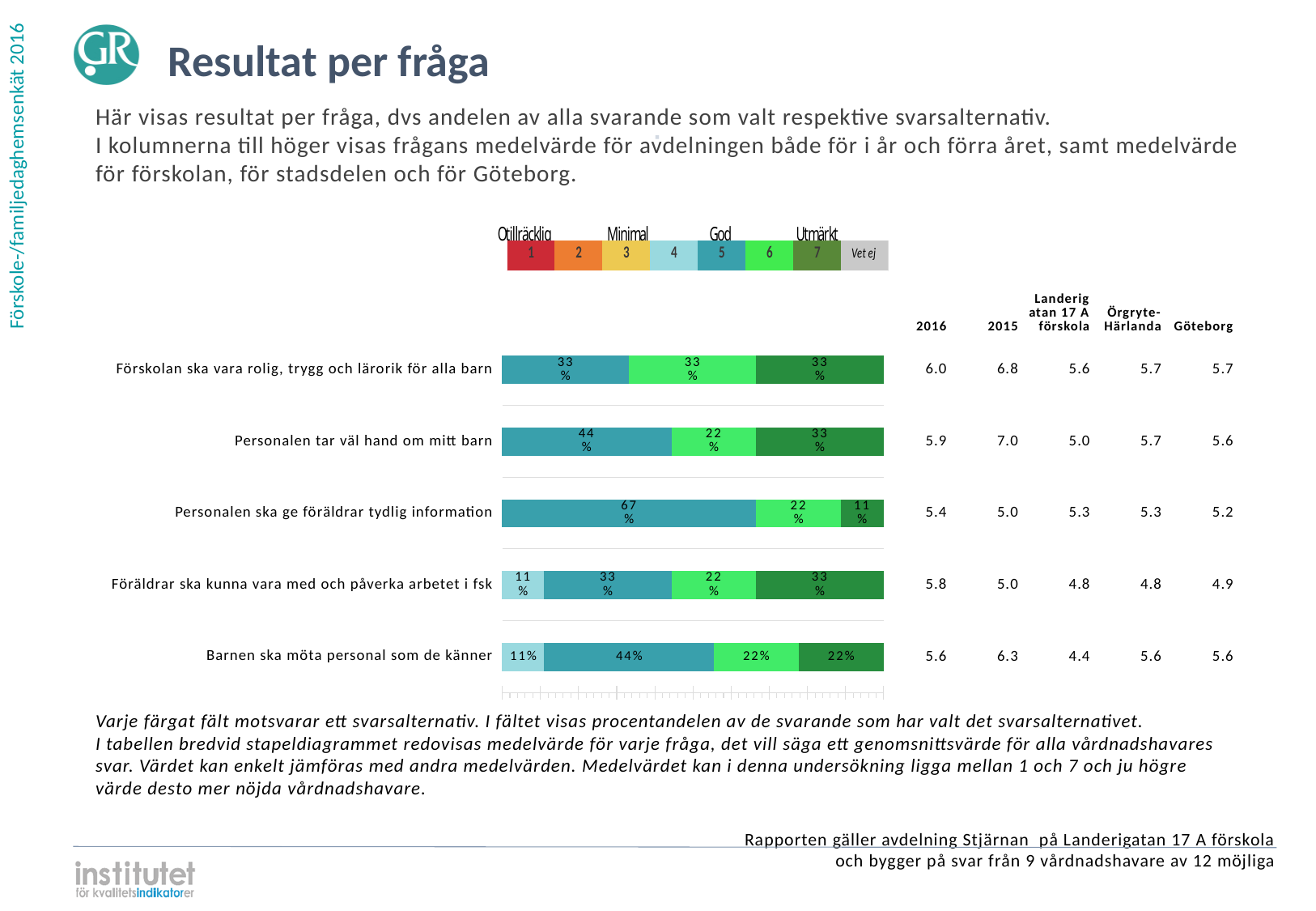
How many questions (categories) are plotted in the bar chart? 5 What kind of chart is shown on the slide? Stacked bar chart How many entries does the colour legend above the chart list? 8 What are the four text labels shown above the colour legend? Otillräcklig, Minimal, God, Utmärkt What is the difference between the rating-5 share for 'Personalen tar väl hand om mitt barn' and the rating-6 share for the same question? 22% What percentage of respondents chose rating 5 (God) for 'Personalen ska ge föräldrar tydlig information'? 67% What is the total of the printed segment values for 'Personalen ska ge föräldrar tydlig information'? 100% For 'Barnen ska möta personal som de känner', which is larger: the rating-5 share or the rating-7 share? Rating 5 (44%) What percentage chose rating 4 for 'Föräldrar ska kunna vara med och påverka arbetet i fsk'? 11% What percentage chose rating 7 for 'Barnen ska möta personal som de känner'? 22% Which question has the largest single segment in its bar? Personalen ska ge föräldrar tydlig information What is the 2016 mean value shown for 'Förskolan ska vara rolig, trygg och lärorik för alla barn'? 6.0